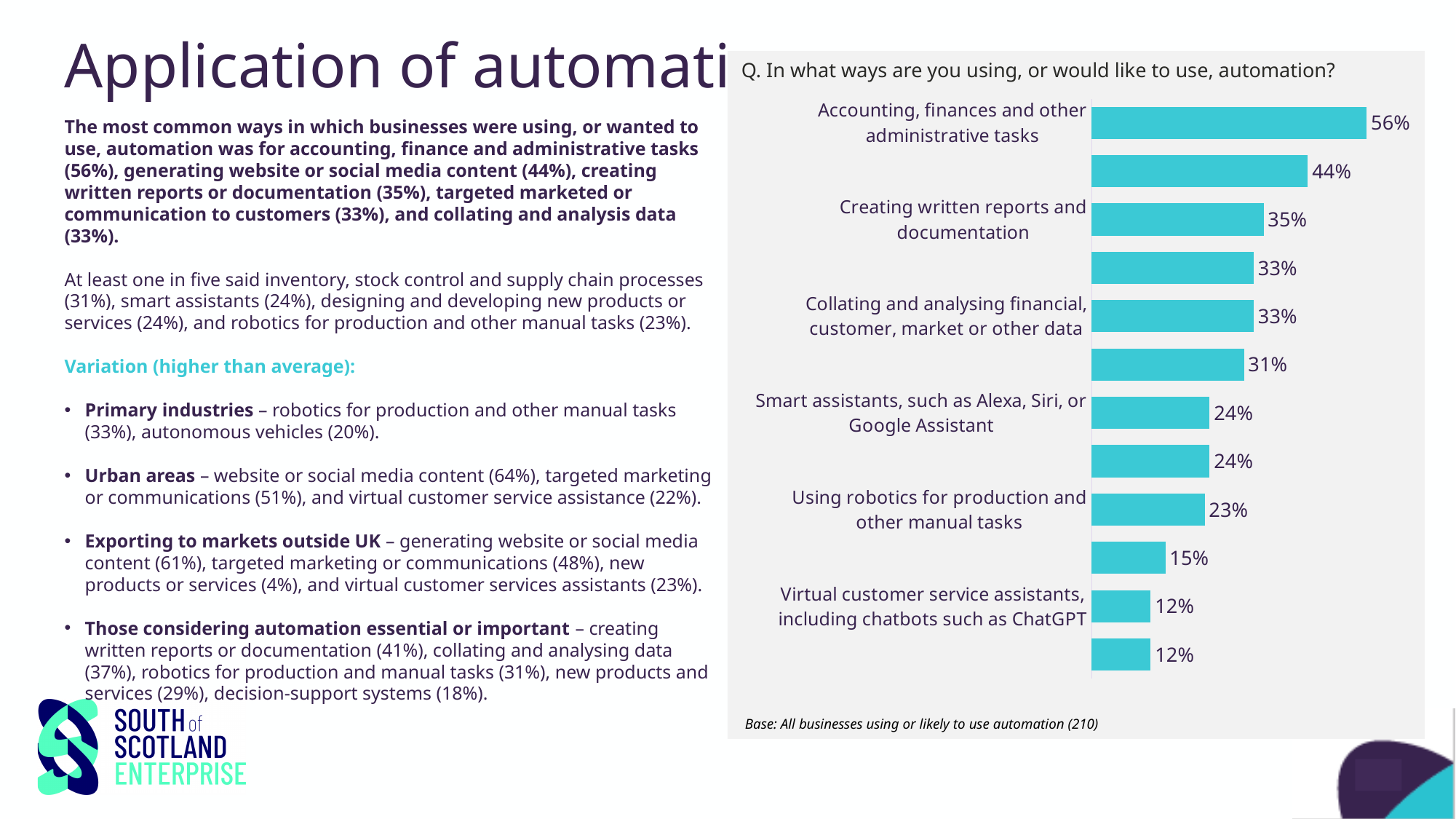
What is the base stated beneath the chart? All businesses using or likely to use automation (210) What percentage is shown for 'Accounting, finances and other administrative tasks'? 56% What percentage is shown for 'Collating and analysing financial, customer, market or other data'? 33% Which category has the highest value in the chart? Accounting, finances and other administrative tasks What is the difference in percentage points between 'Accounting, finances and other administrative tasks' and 'Creating written reports and documentation'? 21 percentage points What percentage is shown for 'Smart assistants, such as Alexa, Siri, or Google Assistant'? 24% What percentage is shown for 'Creating written reports and documentation'? 35% How many bars are plotted in the chart? 12 What percentage is shown for 'Using robotics for production and other manual tasks'? 23% What percentage is shown for 'Virtual customer service assistants, including chatbots such as ChatGPT'? 12% What kind of chart is shown on the slide? Bar chart What is the lowest value shown in the chart? 12%